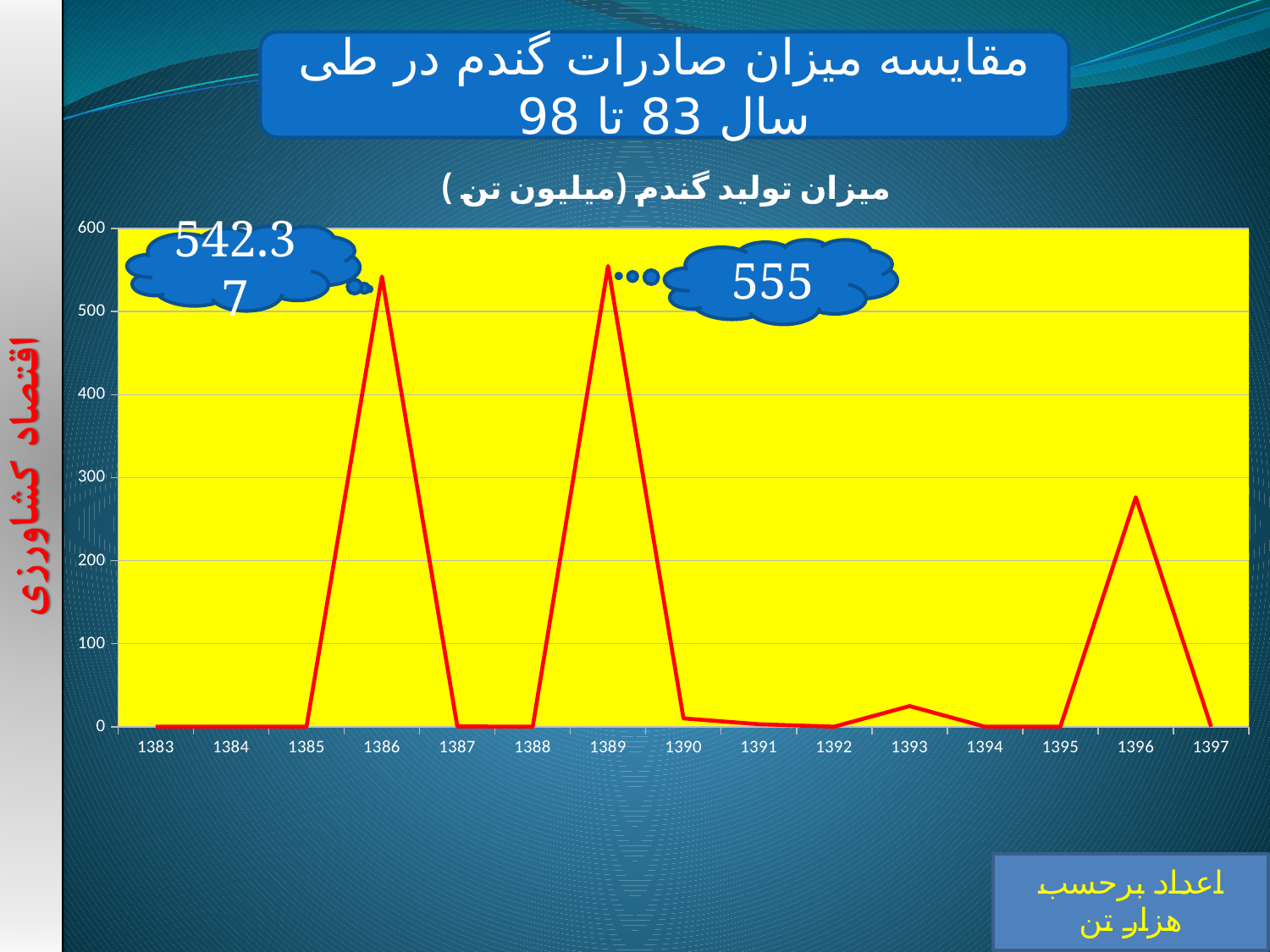
Which is larger, the value for 1389 or the value for 1386? 1389 Which year has the highest value on the chart? 1389 Is the value for 1396 greater or less than 300? less Is the value for 1393 greater or less than 100? less How many years are plotted along the x axis? 15 Which is larger, the value for 1386 or the value for 1396? 1386 What colour is the plotted line on the chart? red What value is labelled for the year 1389? 555 What is the difference between the labelled values for 1389 and 1386? 12.63 What value is labelled for the year 1386? 542.37 What kind of chart is shown on the slide? line chart Is the value for 1396 greater or less than 200? greater